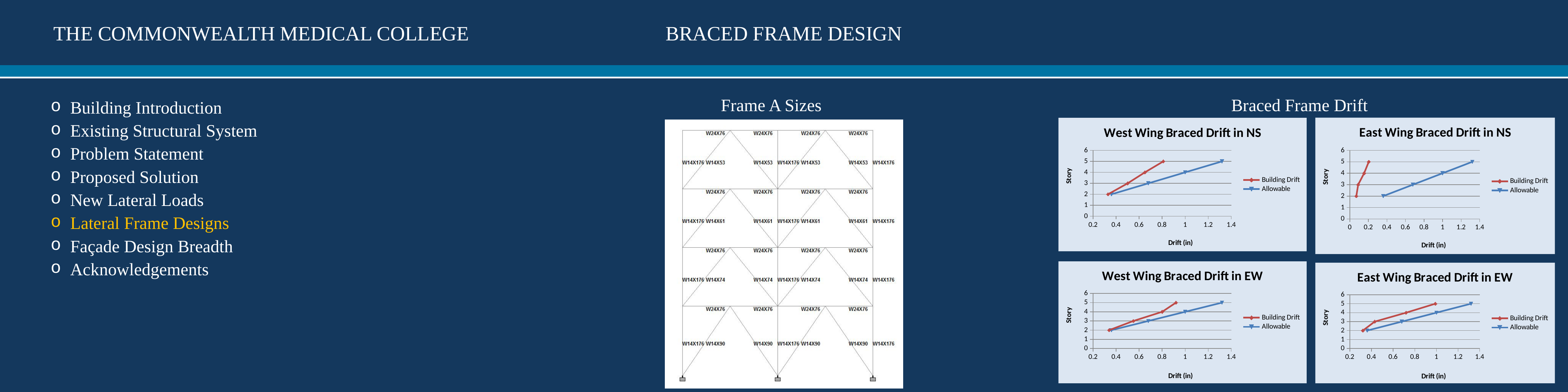
In the West Wing Braced Drift in EW chart, is the Building Drift value at story 5 greater or less than 1? less In the West Wing Braced Drift in NS chart, is the Allowable drift at story 5 greater or less than 1? greater In the East Wing Braced Drift in EW chart, does the story number rise or fall as drift increases along the x axis? rise In the East Wing Braced Drift in NS chart, is the Allowable drift at story 5 greater or less than 1? greater In the East Wing Braced Drift in EW chart, at story 5, which series has the larger drift, Building Drift or Allowable? Allowable In the East Wing Braced Drift in NS chart, how many series does the legend list? 2 In the East Wing Braced Drift in EW chart, what is the label of the horizontal axis? Drift (in) In the West Wing Braced Drift in EW chart, what are the two series named in the legend? Building Drift and Allowable In the West Wing Braced Drift in NS chart, what kind of chart is shown? line chart In the West Wing Braced Drift in NS chart, how many data points are plotted on the Building Drift line? 4